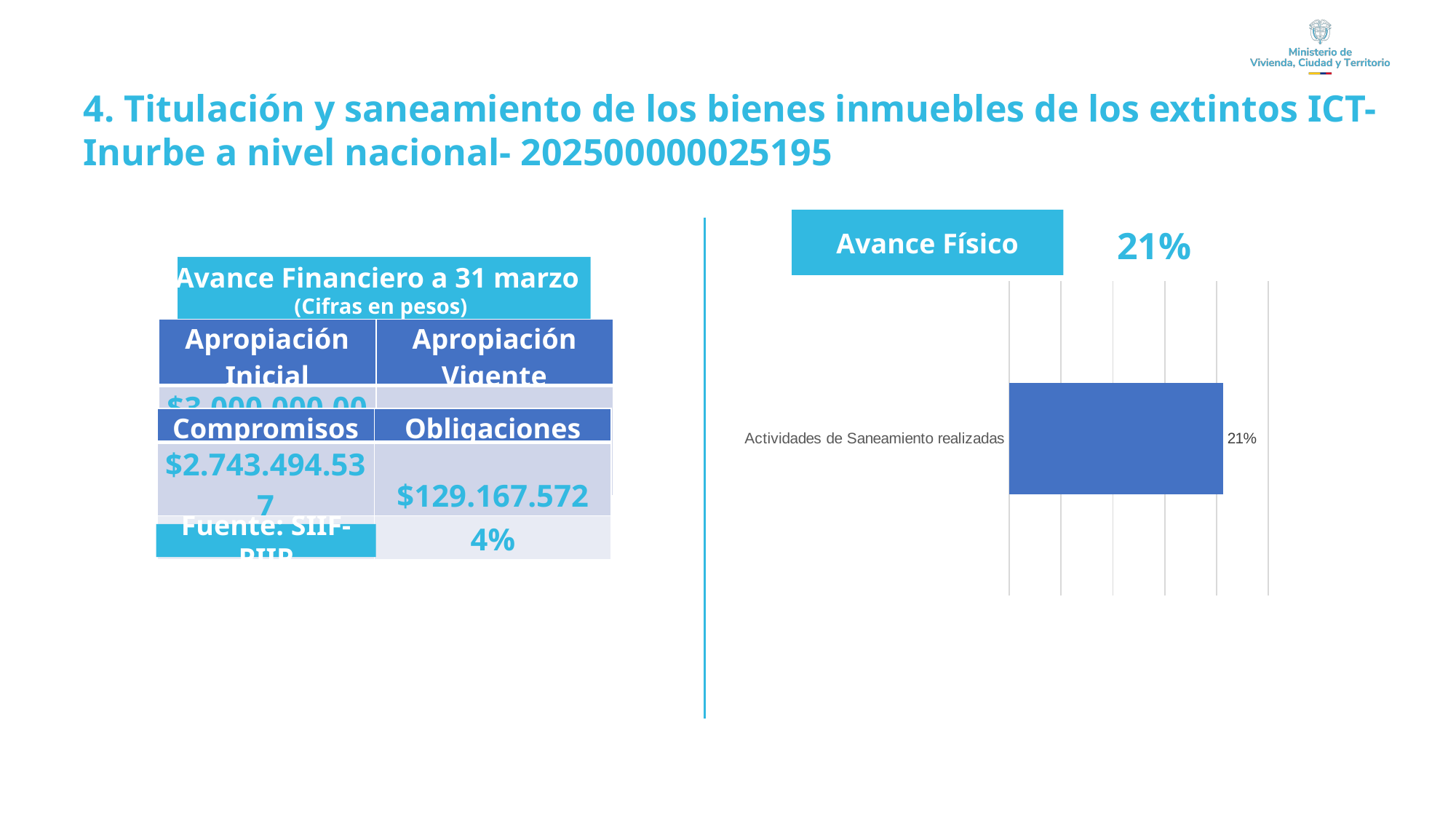
What is the label of the only category in the bar chart? Actividades de Saneamiento realizadas How many categories does the bar chart plot? 1 What value is shown for "Actividades de Saneamiento realizadas" in the bar chart? 21% What kind of chart is shown on the right side of the slide? bar chart What heading appears above the bar chart? Avance Físico